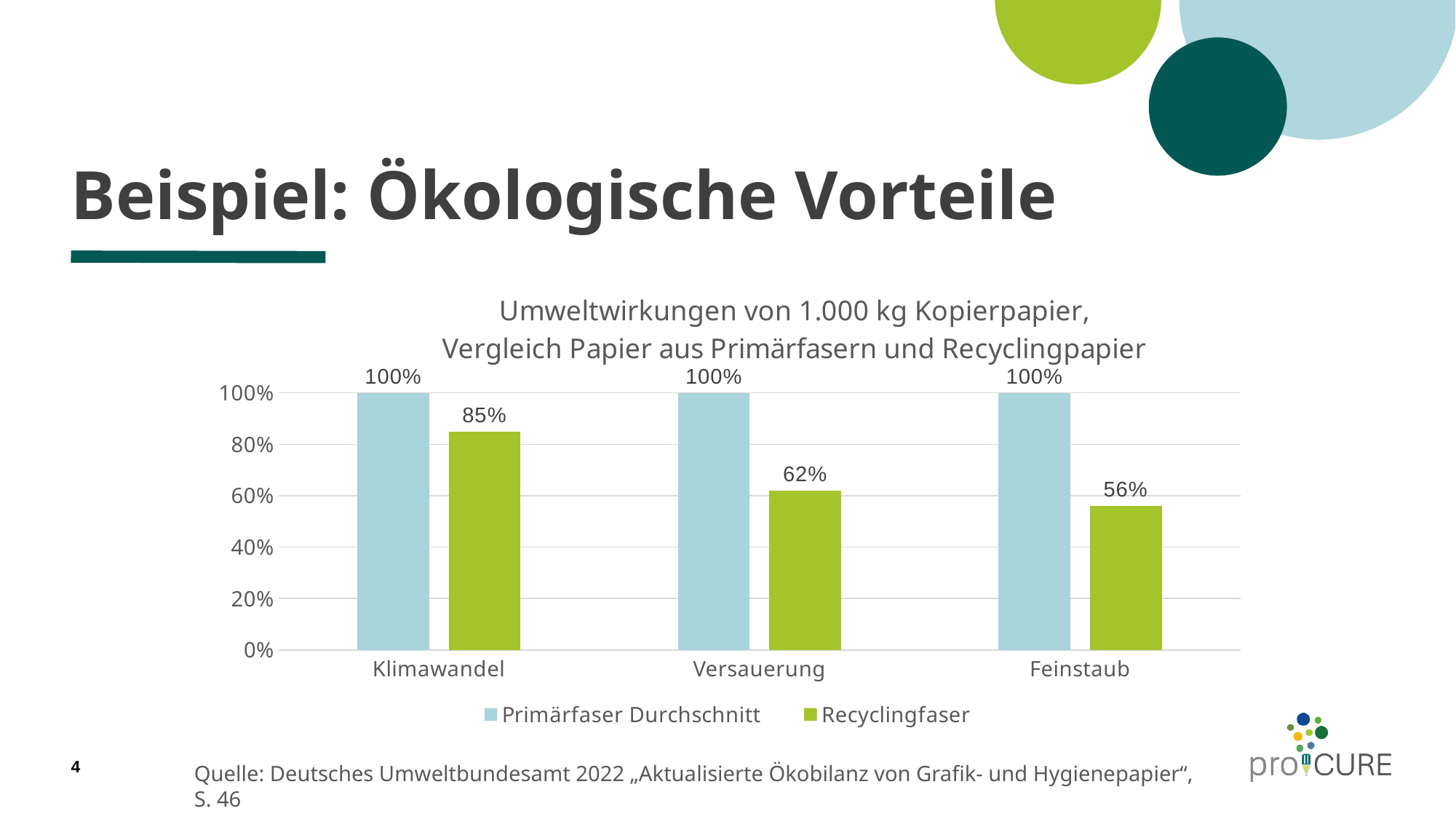
What is the Recyclingfaser value for Versauerung? 62% How many categories are shown on the x axis? 3 Which is larger: the Recyclingfaser value for Versauerung or for Feinstaub? Versauerung What is the Recyclingfaser value for Klimawandel? 85% What kind of chart is shown on the slide? Bar chart What is the difference between the Recyclingfaser values for Klimawandel and Versauerung? 23% For which category is the Recyclingfaser value lowest? Feinstaub What is the difference between the Primärfaser Durchschnitt and Recyclingfaser values for Feinstaub? 44% What is the Recyclingfaser value for Feinstaub? 56% How many series does the legend list? 2 For which category is the Recyclingfaser value highest? Klimawandel What is the Primärfaser Durchschnitt value for Versauerung? 100%